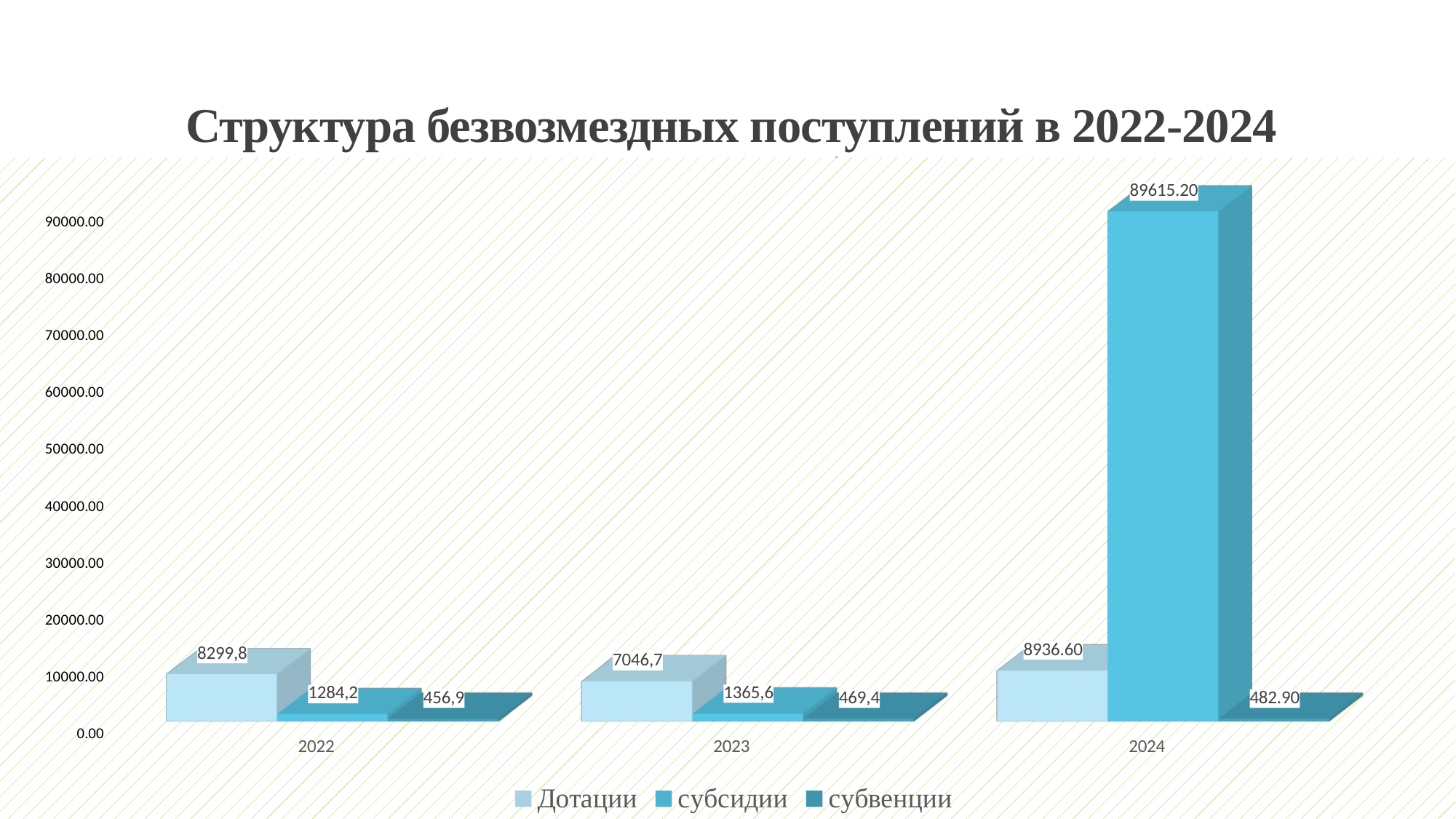
What is the value for субсидии in 2024? 89615.20 What is the value for субвенции in 2023? 469,4 Is the value for субсидии in 2024 greater or less than 80000.00? greater What kind of chart is shown on the slide? bar chart What is the difference between the Дотации values for 2022 and 2023? 1253,1 What is the value for Дотации in 2024? 8936.60 In which year is the value for субсидии highest? 2024 What is the value for Дотации in 2022? 8299,8 In which year is the value for Дотации lowest? 2023 How many years are shown on the x axis? 3 How many series does the legend list? 3 Which is larger in 2023: Дотации or субсидии? Дотации